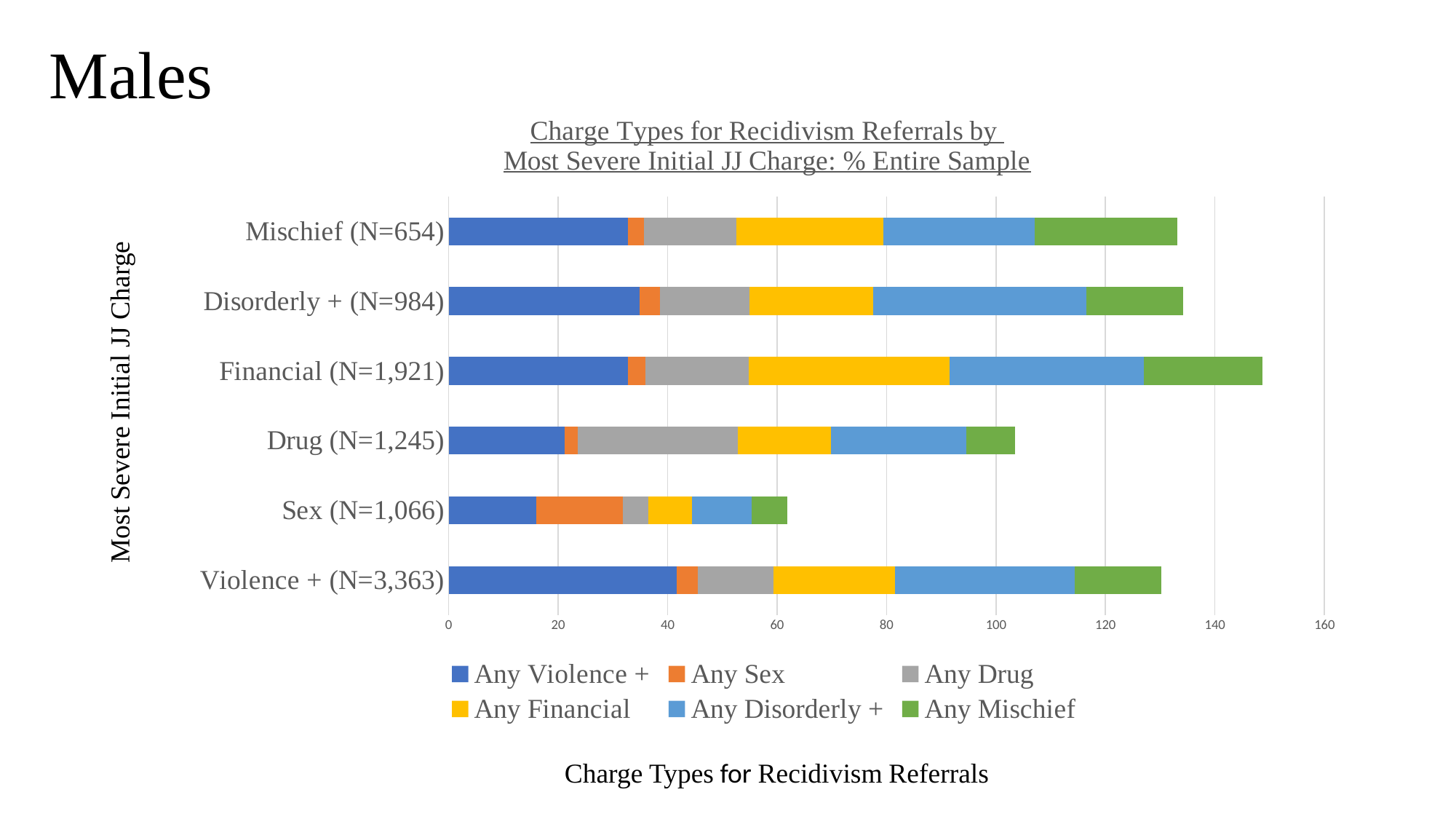
How many initial JJ charge categories are plotted on the y axis? 6 What kind of chart is shown on the slide? stacked bar chart How many series does the legend list? 6 Which initial JJ charge category has the longest total stacked bar? Financial (N=1,921) Is the total stacked bar for Sex (N=1,066) greater or less than 80? less Is the total stacked bar for Financial (N=1,921) greater or less than 140? greater What is the label on the x axis of the chart? Charge Types for Recidivism Referrals Is the total stacked bar for Violence + (N=3,363) greater or less than 120? greater Which category has the longer Any Violence + segment, Violence + (N=3,363) or Sex (N=1,066)? Violence + (N=3,363) Which category has the longest Any Sex segment? Sex (N=1,066) Which has the longer total stacked bar, Drug (N=1,245) or Sex (N=1,066)? Drug (N=1,245) Which initial JJ charge category has the shortest total stacked bar? Sex (N=1,066)